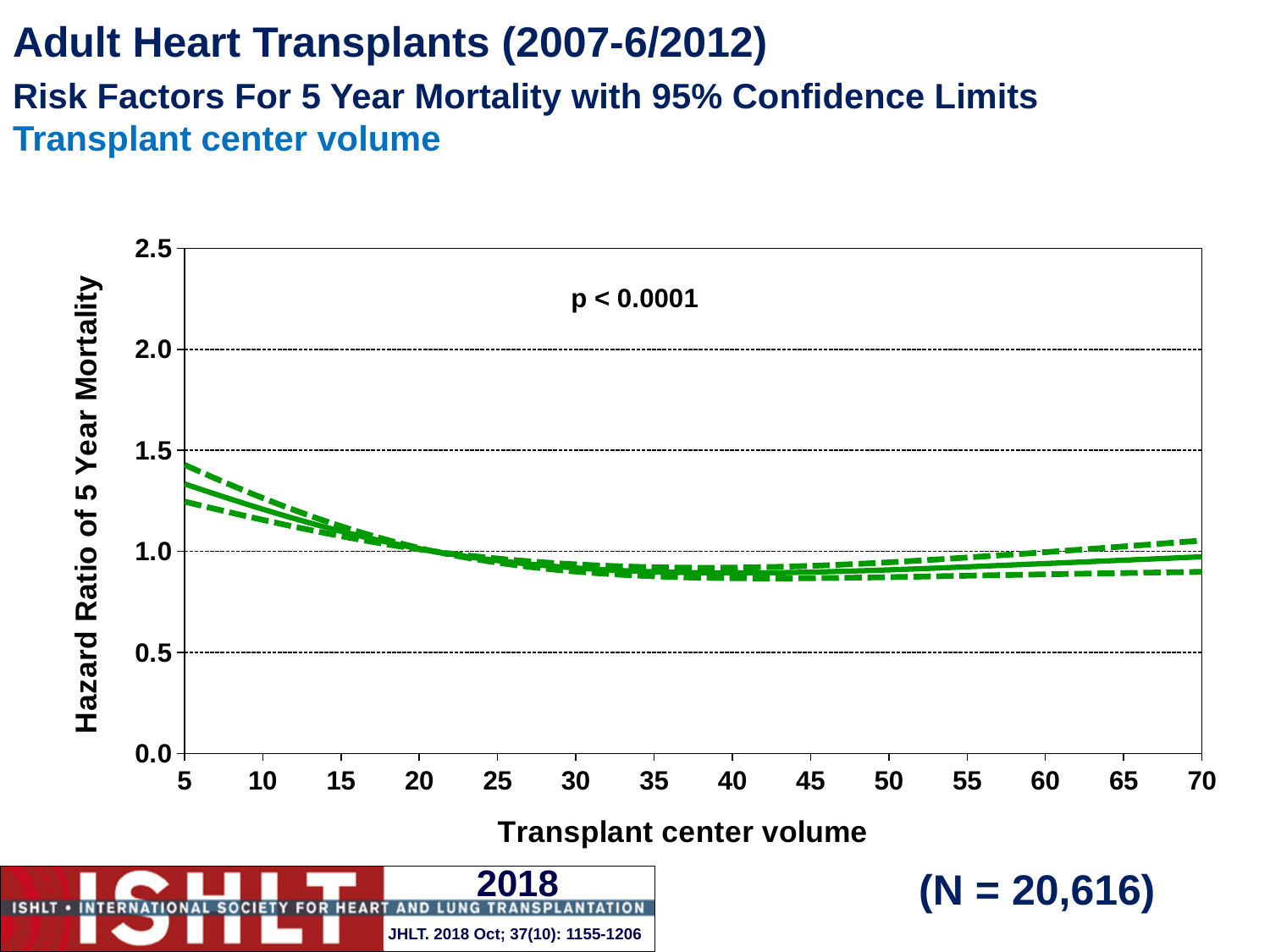
Is the hazard ratio of 5 year mortality at a transplant center volume of 5 greater or less than 1.0? greater Is the hazard ratio of 5 year mortality at a transplant center volume of 40 greater or less than 1.0? less Is the upper 95% confidence limit at a transplant center volume of 5 greater or less than 1.5? less What kind of chart is shown on the slide? Line chart What is the label of the y axis of the chart? Hazard Ratio of 5 Year Mortality Which has the larger hazard ratio of 5 year mortality: a transplant center volume of 5 or 30? 5 What p-value is printed on the chart? p < 0.0001 How does the hazard ratio of 5 year mortality change as transplant center volume increases from 5 to 35? It falls At which transplant center volume shown on the x axis is the hazard ratio of 5 year mortality highest? 5 How many tick labels are shown on the x axis of the chart? 14 Which has the larger hazard ratio of 5 year mortality: a transplant center volume of 10 or 60? 10